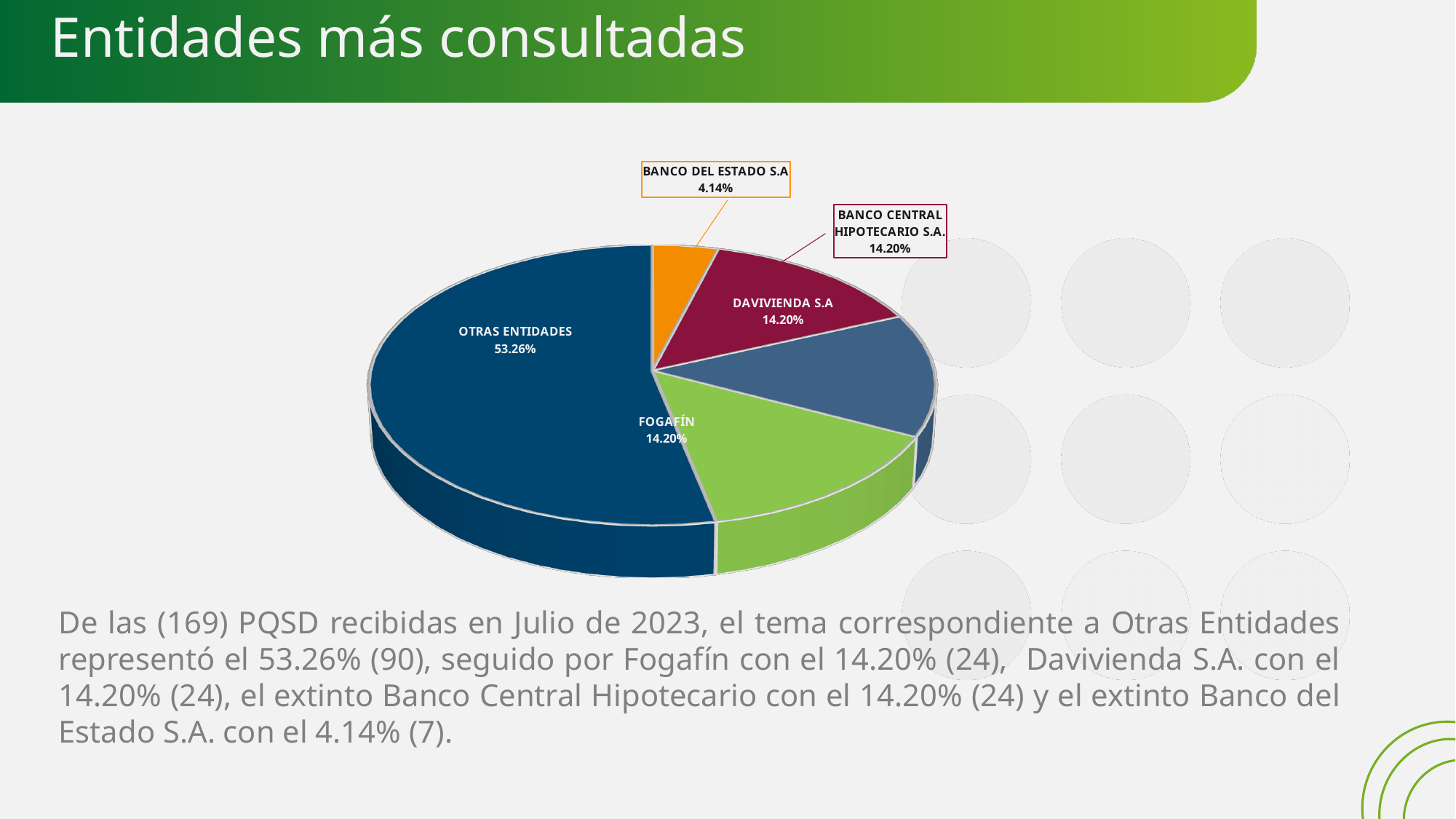
Which category has the largest share of the pie? OTRAS ENTIDADES Which is larger, the share for OTRAS ENTIDADES or the share for FOGAFÍN? OTRAS ENTIDADES What kind of chart is shown on the slide? pie chart What is the value shown for BANCO DEL ESTADO S.A? 4.14% What is the value shown for DAVIVIENDA S.A? 14.20% What is the value shown for FOGAFÍN? 14.20% What is the title of the slide containing the chart? Entidades más consultadas What is the value shown for BANCO CENTRAL HIPOTECARIO S.A.? 14.20% What share of the pie does OTRAS ENTIDADES represent? 53.26% Which category has the smallest share of the pie? BANCO DEL ESTADO S.A What is the difference between the shares of OTRAS ENTIDADES and BANCO DEL ESTADO S.A? 49.12% How many labelled categories are shown in the pie chart? 5